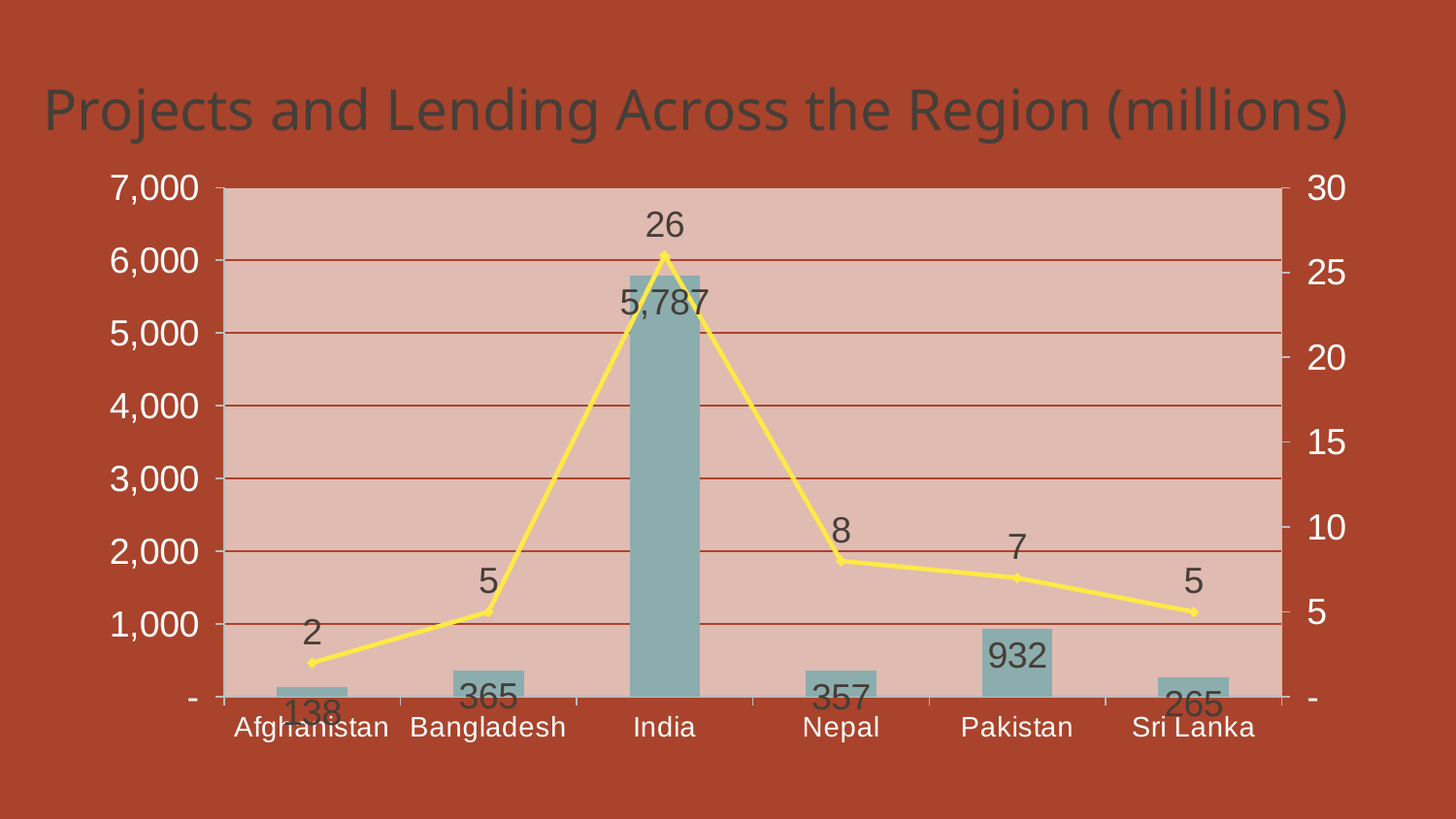
Which country has the lowest bar value? Afghanistan What is the value of the bar for Pakistan? 932 How many countries are shown on the x axis? 6 What value does the line series show for Nepal? 8 Which country has the highest bar value? India What is the value of the bar for India? 5,787 What is the title of the chart? Projects and Lending Across the Region (millions) What is the difference between the line values for India and Nepal? 18 Which has a larger bar value, Bangladesh or Nepal? Bangladesh What value does the line series show for Afghanistan? 2 What is the difference between the bar values for Pakistan and Sri Lanka? 667 Does the line series rise or fall from Nepal to Sri Lanka? fall